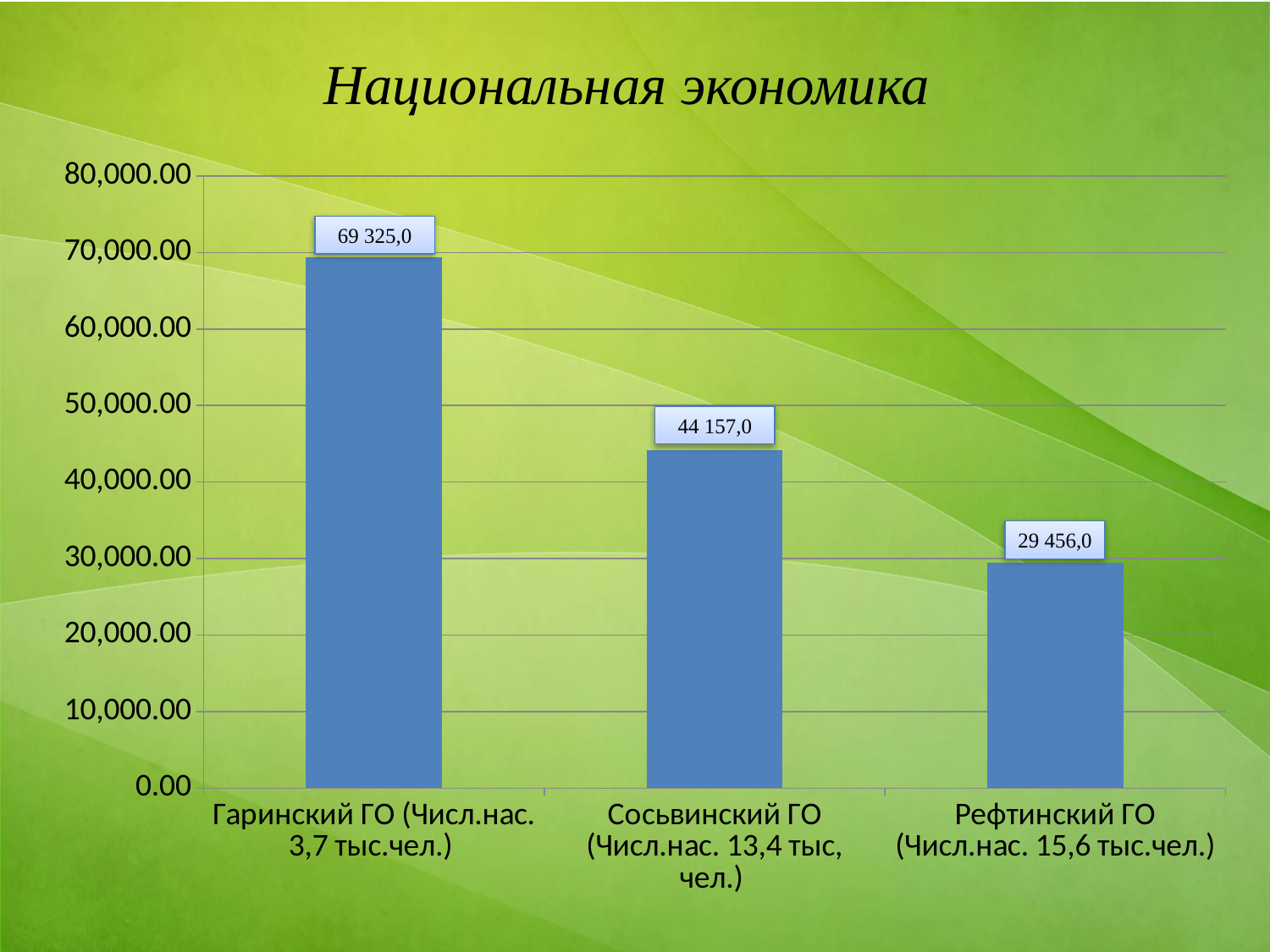
What is the value for Сосьвинский ГО? 44 157,0 What is the value for Гаринский ГО? 69 325,0 How many categories are shown on the chart? 3 Which is larger, the value for Сосьвинский ГО or the value for Рефтинский ГО? Сосьвинский ГО What kind of chart is shown on the slide? bar chart Is the value for Рефтинский ГО greater or less than 30,000.00? less What is the difference between the values for Гаринский ГО and Сосьвинский ГО? 25 168,0 What is the difference between the values for Сосьвинский ГО and Рефтинский ГО? 14 701,0 Which category has the highest value? Гаринский ГО What is the title of the chart? Национальная экономика What is the value for Рефтинский ГО? 29 456,0 Which category has the lowest value? Рефтинский ГО